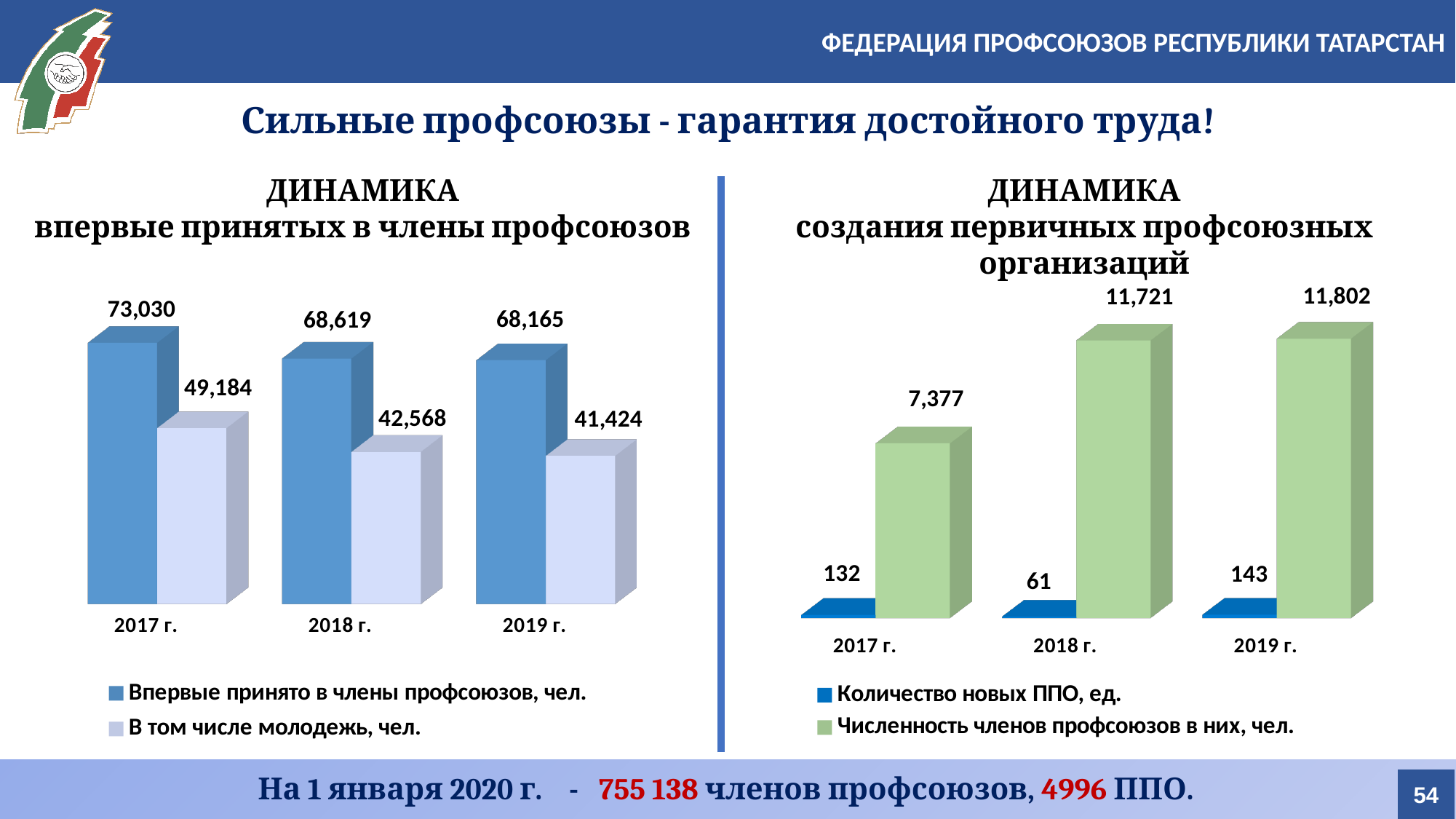
What kind of chart is the left chart (ДИНАМИКА впервые принятых в члены профсоюзов)? bar chart In the left chart (ДИНАМИКА впервые принятых в члены профсоюзов), does the 'Впервые принято в члены профсоюзов, чел.' series rise or fall from 2017 г. to 2019 г.? fall In the left chart (ДИНАМИКА впервые принятых в члены профсоюзов), which year has the lowest value for 'В том числе молодежь, чел.'? 2019 г. In the right chart (ДИНАМИКА создания первичных профсоюзных организаций), what is the value of 'Численность членов профсоюзов в них, чел.' for 2019 г.? 11,802 In the left chart (ДИНАМИКА впервые принятых в члены профсоюзов), what is the value of 'Впервые принято в члены профсоюзов, чел.' for 2017 г.? 73,030 In the left chart (ДИНАМИКА впервые принятых в члены профсоюзов), what is the value of 'В том числе молодежь, чел.' for 2019 г.? 41,424 In the right chart (ДИНАМИКА создания первичных профсоюзных организаций), what is the value of 'Количество новых ППО, ед.' for 2018 г.? 61 In the right chart (ДИНАМИКА создания первичных профсоюзных организаций), which year has the highest value for 'Количество новых ППО, ед.'? 2019 г. In the right chart (ДИНАМИКА создания первичных профсоюзных организаций), how many series does the legend list? 2 In the left chart (ДИНАМИКА впервые принятых в члены профсоюзов), which year has the highest value for 'Впервые принято в члены профсоюзов, чел.'? 2017 г. In the left chart (ДИНАМИКА впервые принятых в члены профсоюзов), what is the difference between the 'Впервые принято в члены профсоюзов, чел.' values for 2017 г. and 2018 г.? 4,411 In the right chart (ДИНАМИКА создания первичных профсоюзных организаций), what is the difference between the 'Численность членов профсоюзов в них, чел.' values for 2019 г. and 2017 г.? 4,425